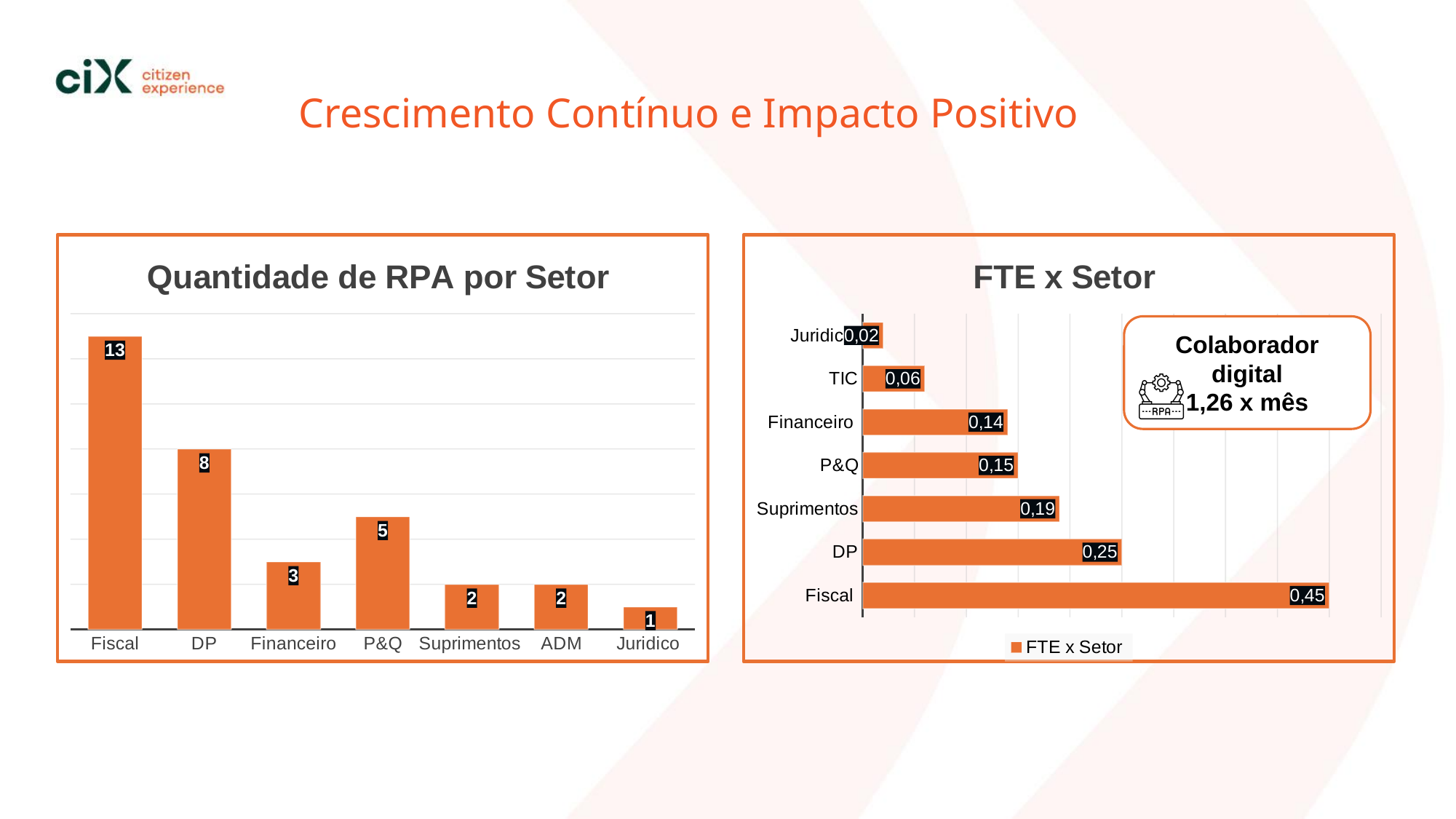
In the 'Quantidade de RPA por Setor' chart, which sector has the lowest value? Juridico What kind of chart is 'FTE x Setor'? Bar chart In the 'Quantidade de RPA por Setor' chart, what is the value for Fiscal? 13 In the 'FTE x Setor' chart, how many series does the legend list? 1 In the 'FTE x Setor' chart, what is the difference between Fiscal and DP? 0,20 In the 'Quantidade de RPA por Setor' chart, what is the difference between Fiscal and DP? 5 What is the title of the chart on the left of the slide? Quantidade de RPA por Setor In the 'FTE x Setor' chart, what is the value for Suprimentos? 0,19 In the 'Quantidade de RPA por Setor' chart, how many sectors are shown? 7 In the 'FTE x Setor' chart, which sector has the highest value? Fiscal In the 'Quantidade de RPA por Setor' chart, which is larger, Financeiro or P&Q? P&Q In the 'FTE x Setor' chart, what is the value for TIC? 0,06